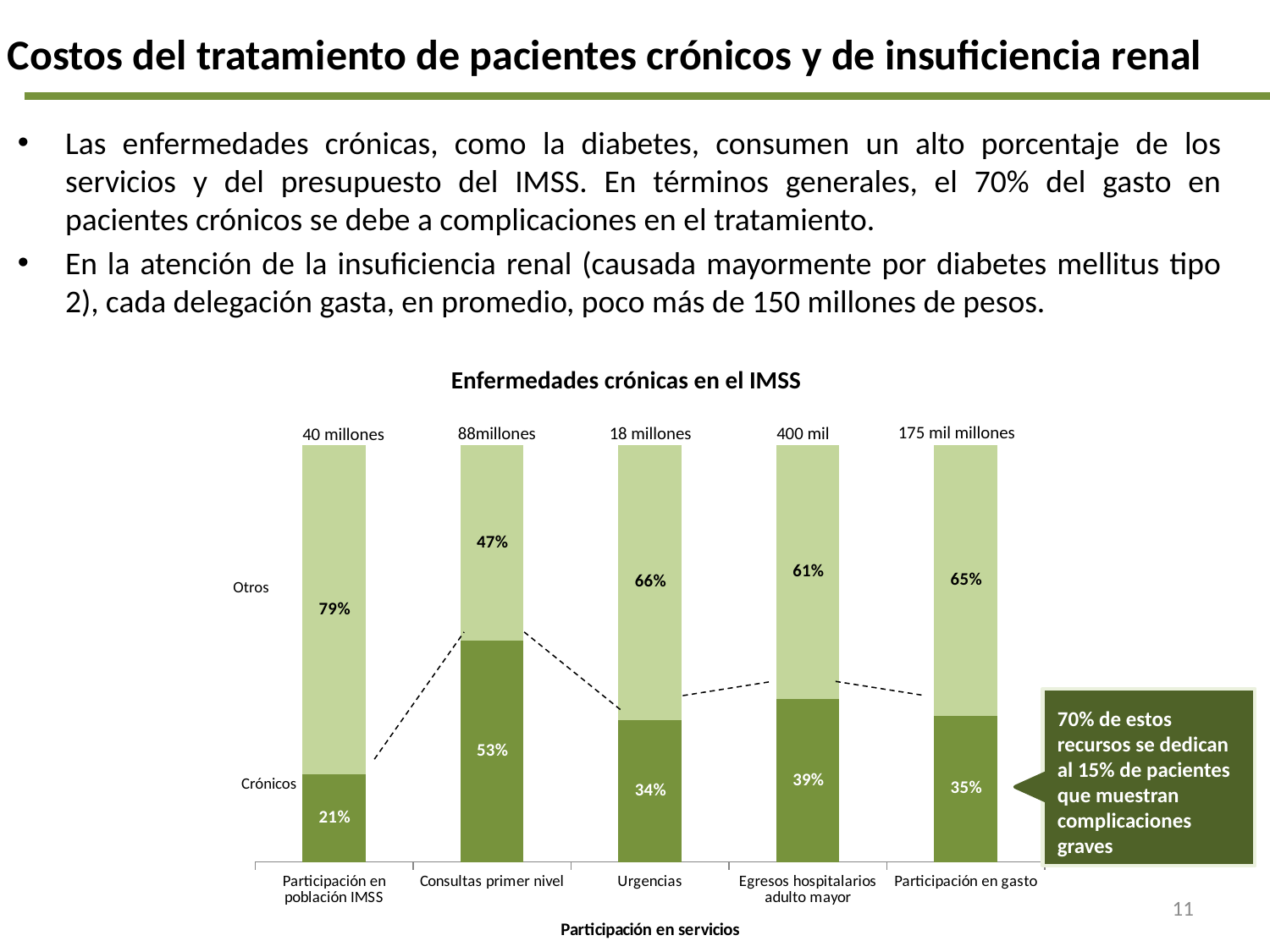
What is the Crónicos share for Consultas primer nivel? 53% What total is printed above the Participación en gasto bar? 175 mil millones Which category has the lowest Crónicos share? Participación en población IMSS What is the Otros share for Participación en gasto? 65% What type of chart is shown on the slide? Stacked bar chart Which category has the highest Crónicos share? Consultas primer nivel Which is larger, the Crónicos share for Egresos hospitalarios adulto mayor or for Participación en gasto? Egresos hospitalarios adulto mayor What is the title of the chart? Enfermedades crónicas en el IMSS What is the Crónicos share for Egresos hospitalarios adulto mayor? 39% What is the Otros share for Participación en población IMSS? 79% How many categories are shown along the x axis of the chart? 5 What is the difference between the Crónicos share for Urgencias and for Participación en población IMSS? 13%